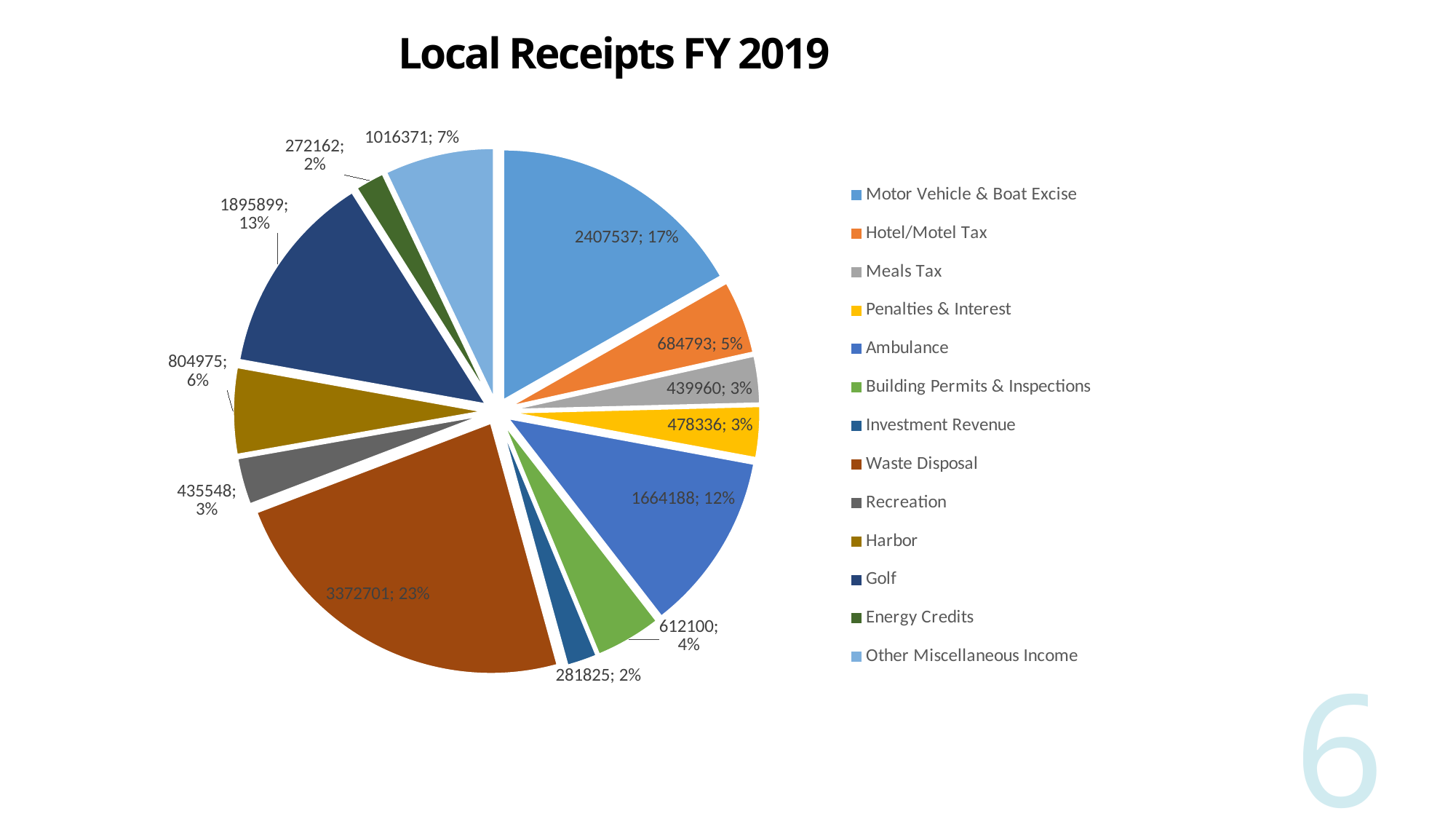
Which is larger, Hotel/Motel Tax or Harbor? Harbor What percentage share does Other Miscellaneous Income have? 7% Which category has the smallest slice? Energy Credits How many categories are shown in the pie chart? 13 What is the value for Golf? 1895899 What is the title of the chart? Local Receipts FY 2019 What is the difference between the values for Golf and Ambulance? 231711 What kind of chart is shown on the slide? Pie chart What percentage share does Motor Vehicle & Boat Excise have? 17% Which category has the largest slice? Waste Disposal What is the value for Ambulance? 1664188 What is the value for Waste Disposal? 3372701